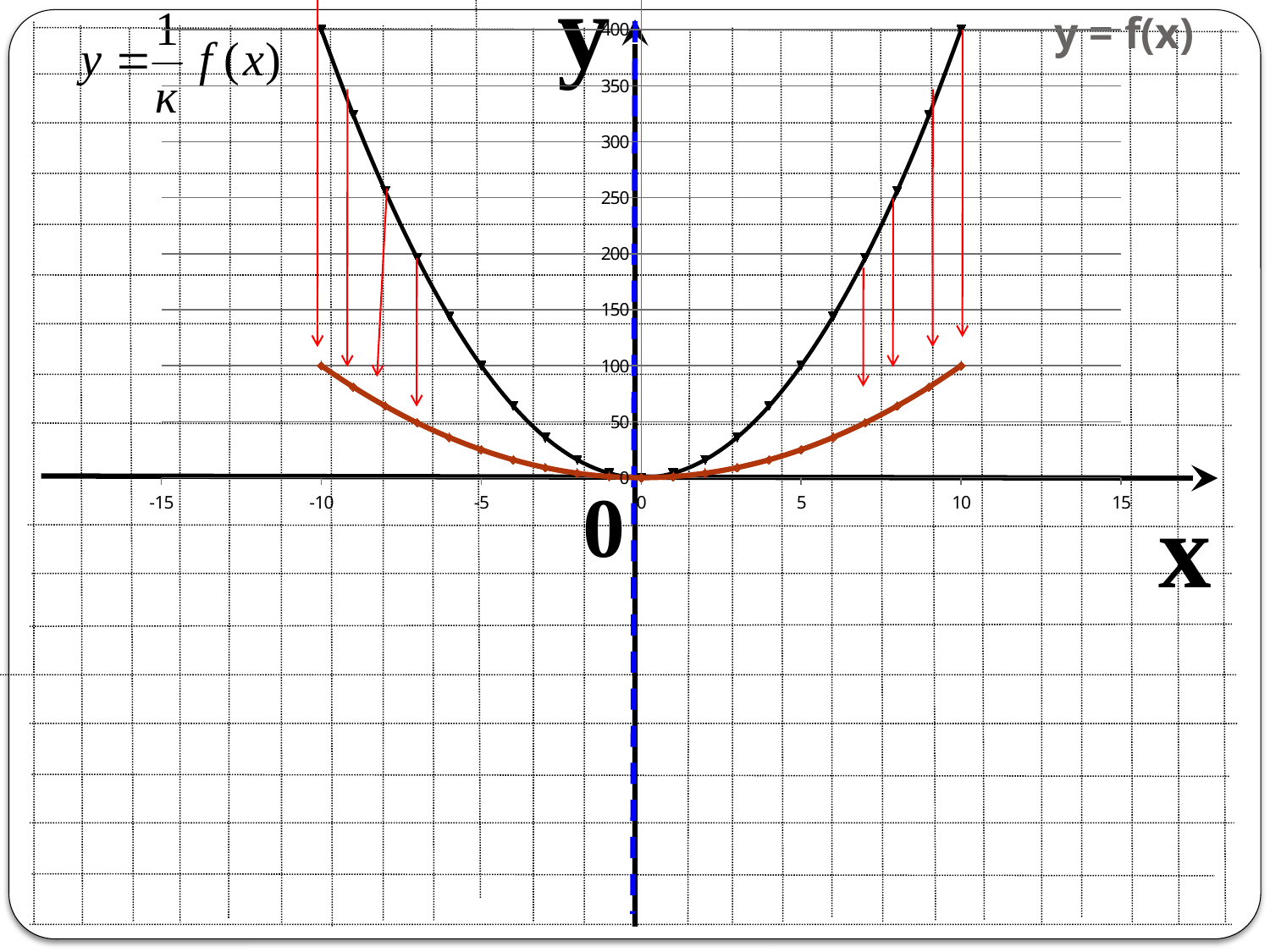
What is the value of y = f(x) at x = -10? 400 What is the minimum value of y = f(x) on the chart? 0 What colour is the y = f(x) curve? black What is the value of the y = (1/k) f(x) curve at x = 10? 100 As x increases from 0 to 10, does y = f(x) rise or fall? rise What is the value of y = f(x) at x = 10? 400 Is the value of y = f(x) at x = 7 greater or less than 150? greater Is the value of y = (1/k) f(x) at x = 5 greater or less than 50? less What kind of chart is shown on the slide? line chart What is the difference between y = f(x) and y = (1/k) f(x) at x = 10? 300 Is the value of y = f(x) at x = 5 greater or less than 200? less At x = 10, which curve has the larger value, y = f(x) or y = (1/k) f(x)? y = f(x)